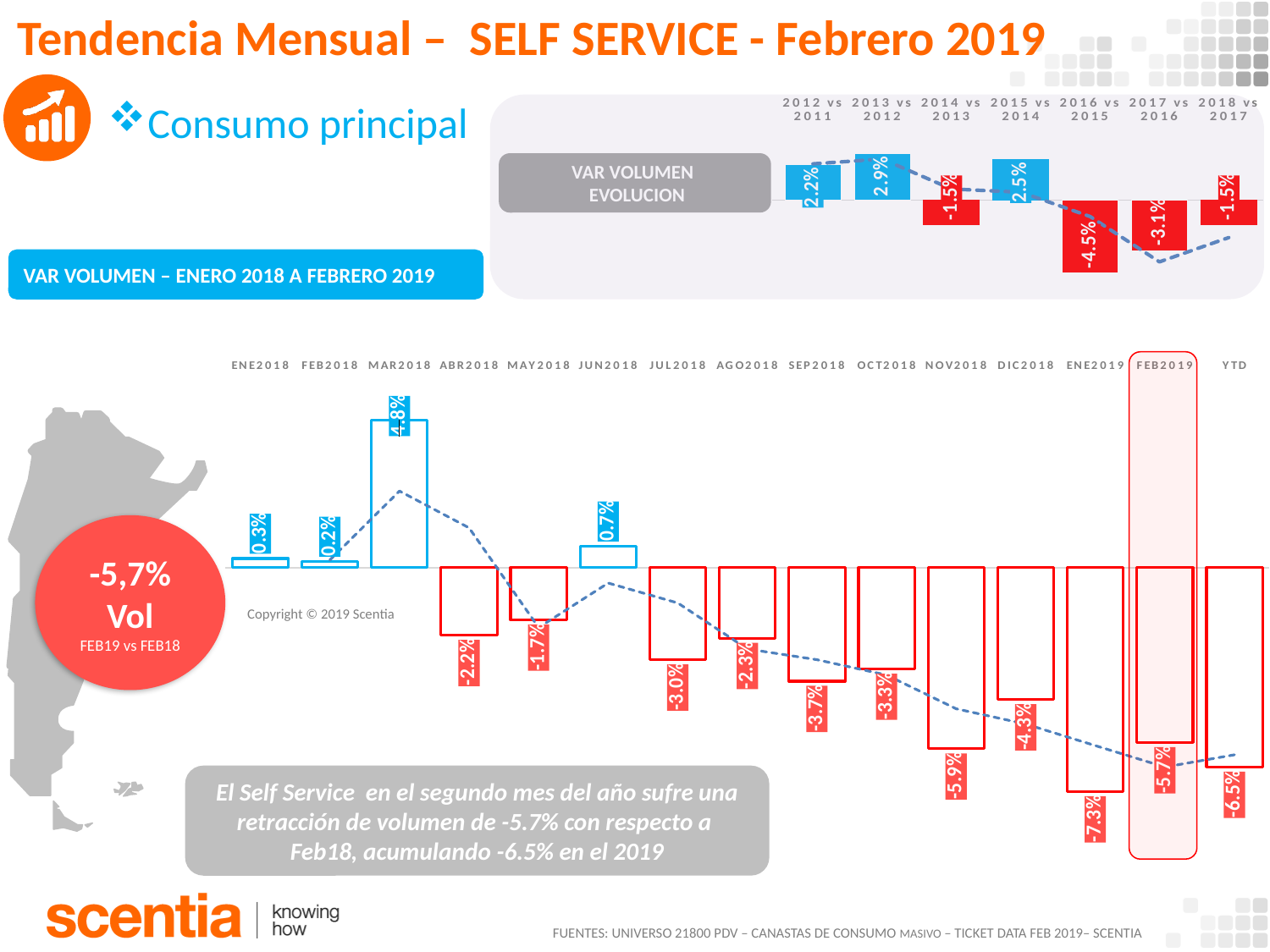
In the VAR VOLUMEN – ENERO 2018 A FEBRERO 2019 chart, what is the value for NOV2018? -5.9% What kind of chart is the VAR VOLUMEN – ENERO 2018 A FEBRERO 2019 chart? Bar chart with a dashed trend line In the VAR VOLUMEN – ENERO 2018 A FEBRERO 2019 chart, what is the value for FEB2019? -5.7% In the VAR VOLUMEN EVOLUCION chart, what is the value for 2016 vs 2015? -4.5% In the VAR VOLUMEN EVOLUCION chart, which period has the highest value? 2013 vs 2012 In the VAR VOLUMEN – ENERO 2018 A FEBRERO 2019 chart, which month has the lowest value? ENE2019 In the VAR VOLUMEN EVOLUCION chart, what is the difference between the values for 2013 vs 2012 and 2012 vs 2011? 0.7 percentage points In the VAR VOLUMEN – ENERO 2018 A FEBRERO 2019 chart, which is larger, the value for JUN2018 or the value for JUL2018? JUN2018 In the VAR VOLUMEN – ENERO 2018 A FEBRERO 2019 chart, what is the difference between the values for ENE2019 and FEB2019? 1.6 percentage points How many monthly categories (excluding YTD) are shown in the VAR VOLUMEN – ENERO 2018 A FEBRERO 2019 chart? 14 In the VAR VOLUMEN – ENERO 2018 A FEBRERO 2019 chart, which month has the highest value? MAR2018 In the VAR VOLUMEN – ENERO 2018 A FEBRERO 2019 chart, what is the value for YTD? -6.5%